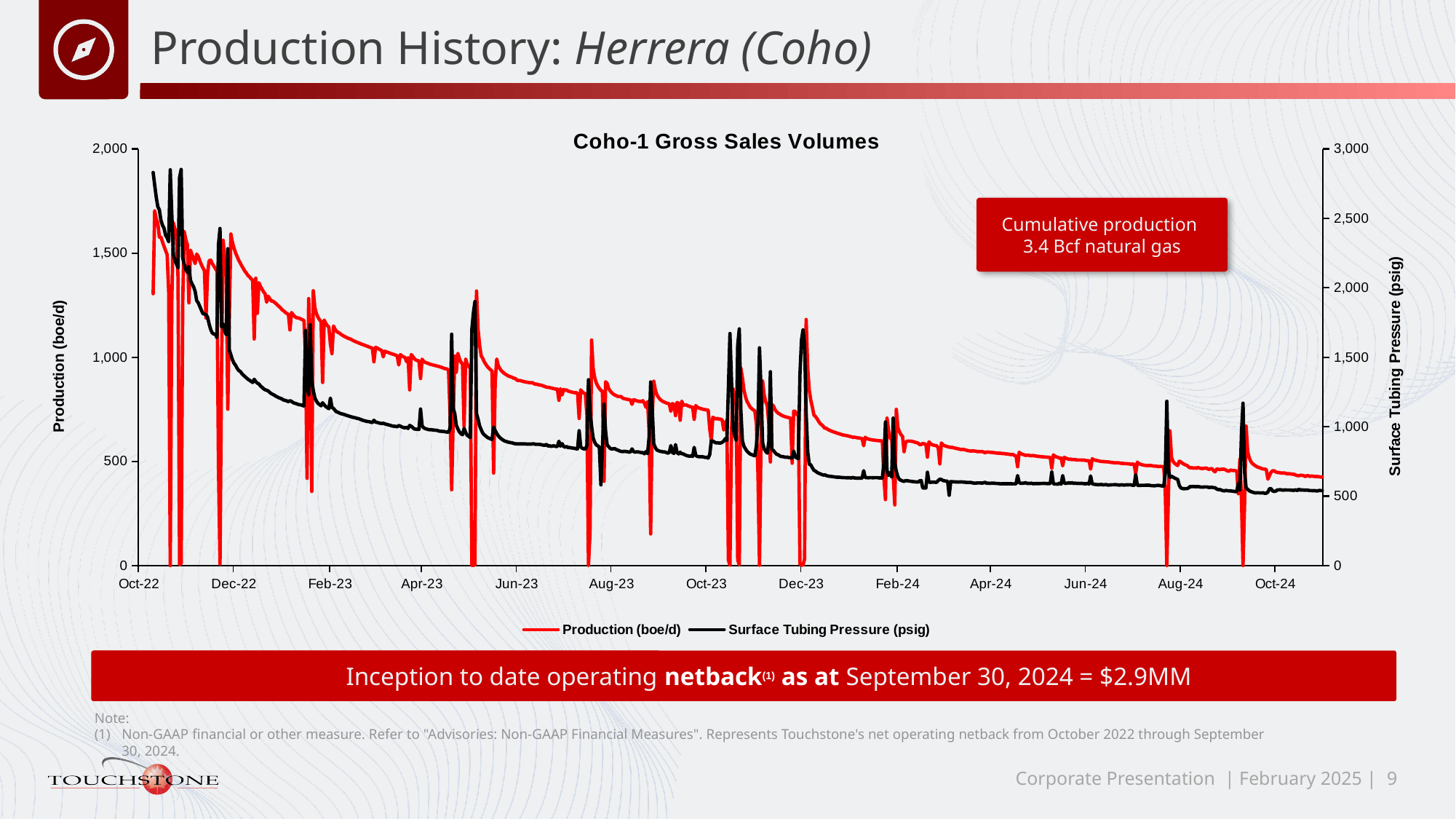
What kind of chart is shown on the slide? Line chart What is the maximum value shown on the left-hand Production (boe/d) axis? 2,000 Is the Surface Tubing Pressure (psig) value around Oct-24 greater or less than 1,000? less Is the Production (boe/d) value around Oct-24 greater or less than 500? less Is the Surface Tubing Pressure (psig) value at the start of the chart in Oct-22 greater or less than 2,500? greater How many series does the chart's legend list? 2 Which series is drawn in red in the chart? Production (boe/d) Does the Surface Tubing Pressure (psig) series generally rise or fall over the period shown? Fall Does the Production (boe/d) series generally rise or fall from Oct-22 to Oct-24? Fall What is the title of the chart? Coho-1 Gross Sales Volumes